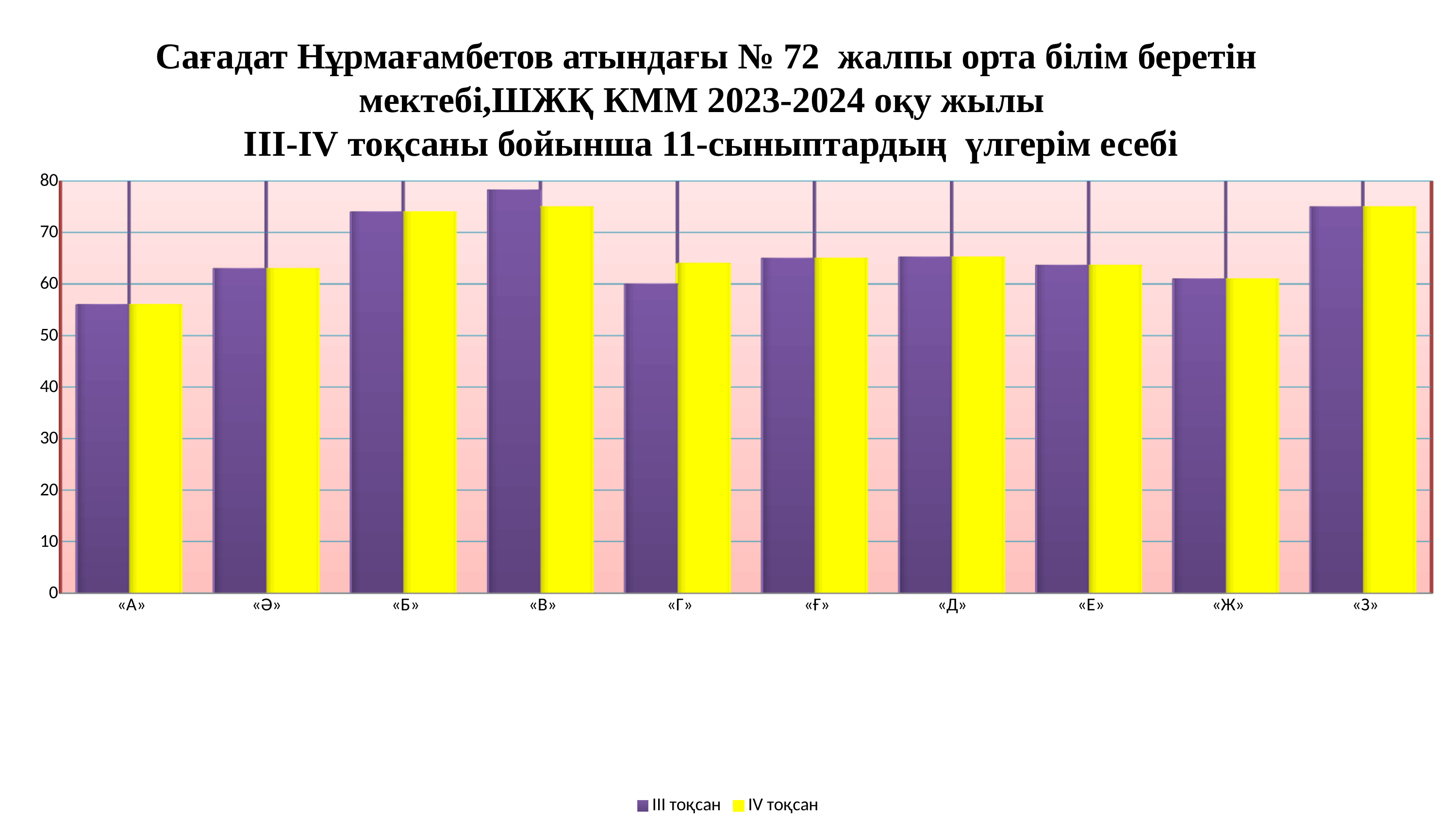
What kind of chart is shown on the slide? bar chart Is the IV тоқсан value for «Б» greater or less than 70? greater Is the IV тоқсан value for «Г» greater or less than 60? greater Which category has the lowest III тоқсан value? «А» Is the III тоқсан value for «А» greater or less than 60? less What are the two series named in the legend? III тоқсан and IV тоқсан For «В», which is larger: the III тоқсан value or the IV тоқсан value? III тоқсан Which category has the highest III тоқсан value? «В» How many series does the legend list? 2 Which category has the lowest IV тоқсан value? «А» How many categories are shown on the x axis? 10